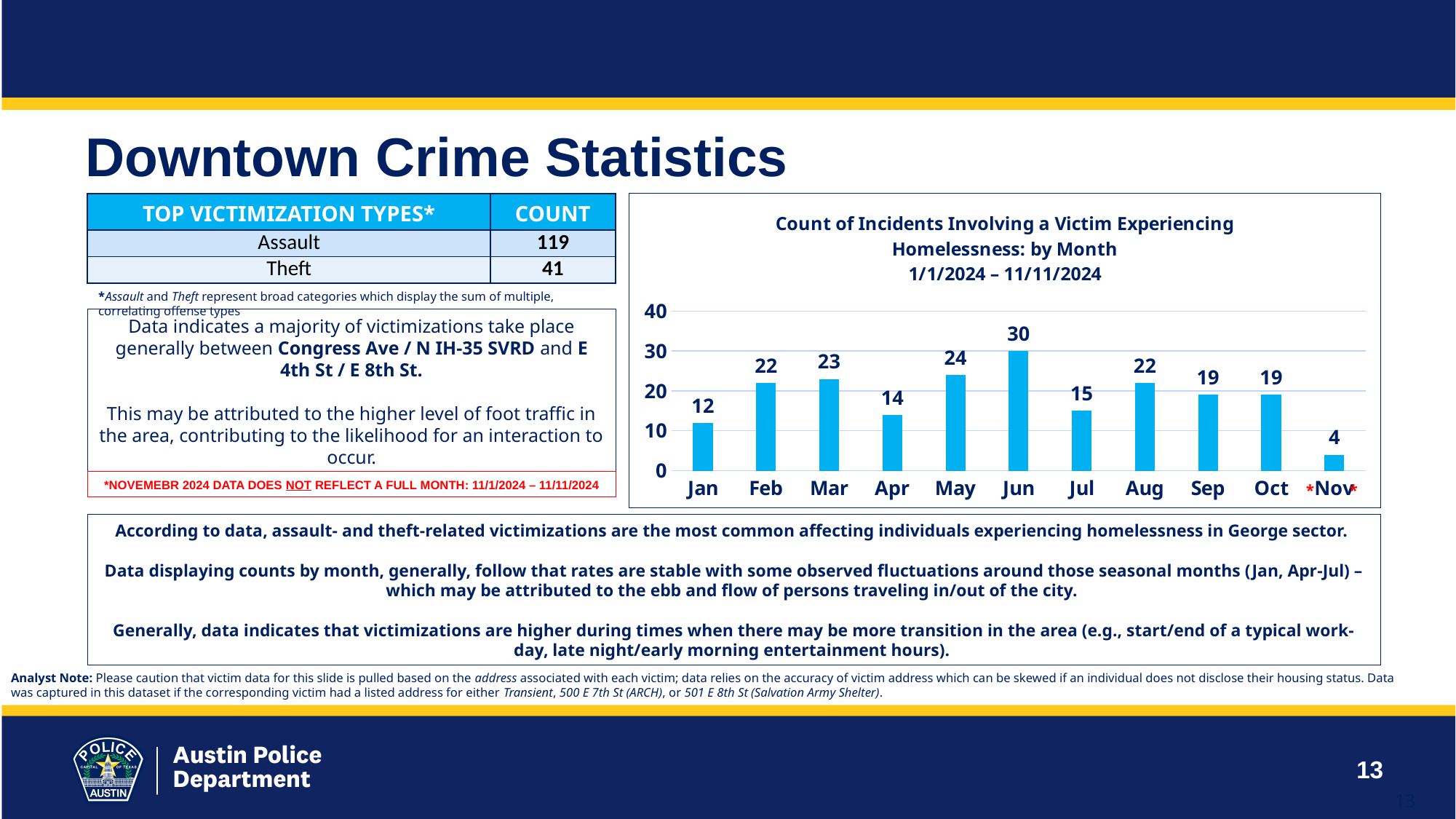
How many months are shown on the x axis of the chart? 11 What is the difference between the counts for Jun and Jul? 15 What is the count of incidents for Jun? 30 Is the value for May greater or less than 20? greater Which month has the highest count of incidents? Jun Which month has a higher count, Mar or Apr? Mar Which month has the lowest count of incidents? Nov What is the count of incidents for Jan? 12 What date range is given in the chart title? 1/1/2024 – 11/11/2024 Do the counts rise or fall from Aug to Nov? fall What kind of chart is shown on the slide? bar chart What is the count of incidents for Nov? 4